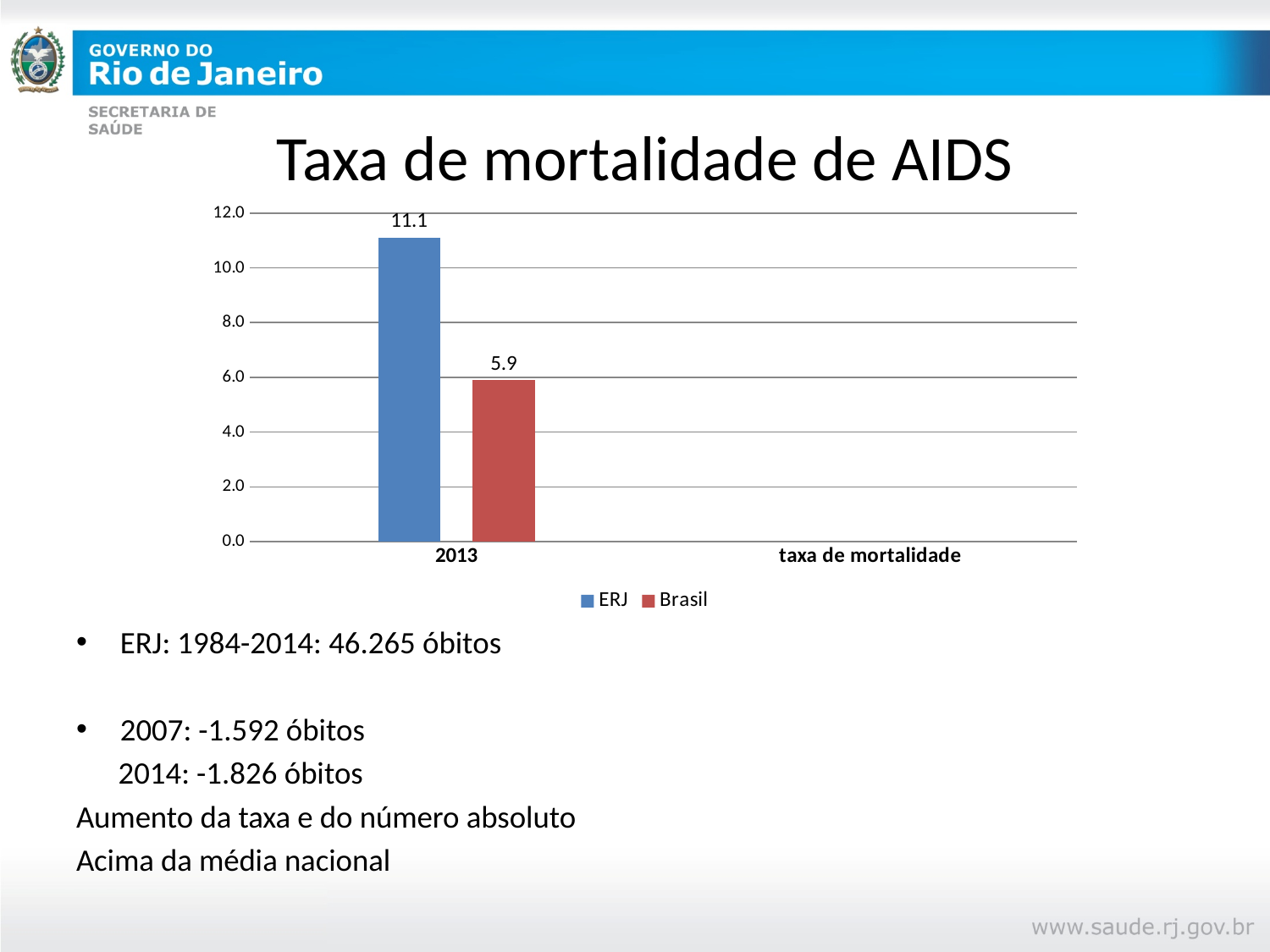
What is the value for ERJ in 2013? 11.1 What is the value for Brasil in 2013? 5.9 How many series does the legend list? 2 Which series has the higher value in 2013, ERJ or Brasil? ERJ Is the value for Brasil in 2013 greater or less than 6.0? less What colour are the bars for the Brasil series? red Is the value for ERJ in 2013 greater or less than 10.0? greater What kind of chart is shown on the slide? bar chart What is the highest value shown on the y axis? 12.0 Which series has the lowest value in 2013? Brasil What is the difference between the ERJ and Brasil values in 2013? 5.2 What is the title of the chart? Taxa de mortalidade de AIDS